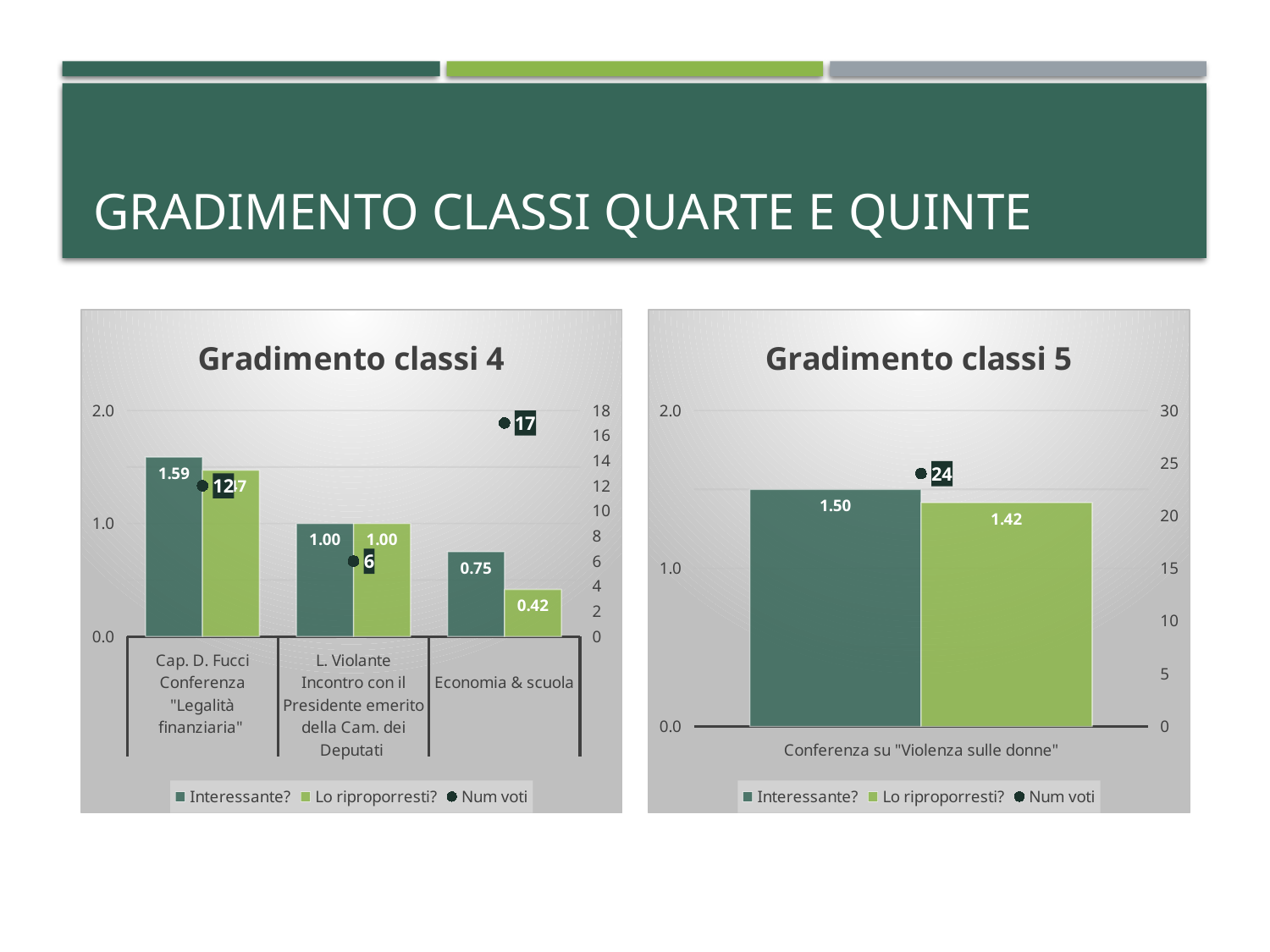
In the "Gradimento classi 5" chart, what is the "Num voti" value? 24 In the "Gradimento classi 4" chart, which category has the lowest "Num voti" value? L. Violante Incontro con il Presidente emerito della Cam. dei Deputati In the "Gradimento classi 5" chart, what is the "Interessante?" value for Conferenza su "Violenza sulle donne"? 1.50 In the "Gradimento classi 5" chart, which is larger, the "Interessante?" value or the "Lo riproporresti?" value? Interessante? In the "Gradimento classi 4" chart, what is the difference between the "Interessante?" and "Lo riproporresti?" values for Economia & scuola? 0.33 In the "Gradimento classi 4" chart, which category has the highest "Interessante?" value? Cap. D. Fucci Conferenza "Legalità finanziaria" In the "Gradimento classi 4" chart, what is the "Lo riproporresti?" value for Economia & scuola? 0.42 In the "Gradimento classi 4" chart, what is the "Num voti" value for Economia & scuola? 17 In the "Gradimento classi 4" chart, how many categories are shown on the x axis? 3 In the "Gradimento classi 4" chart, what is the "Interessante?" value for Cap. D. Fucci Conferenza "Legalità finanziaria"? 1.59 How many series does the legend of the "Gradimento classi 5" chart list? 3 In the "Gradimento classi 4" chart, what is the "Num voti" value for L. Violante Incontro con il Presidente emerito della Cam. dei Deputati? 6